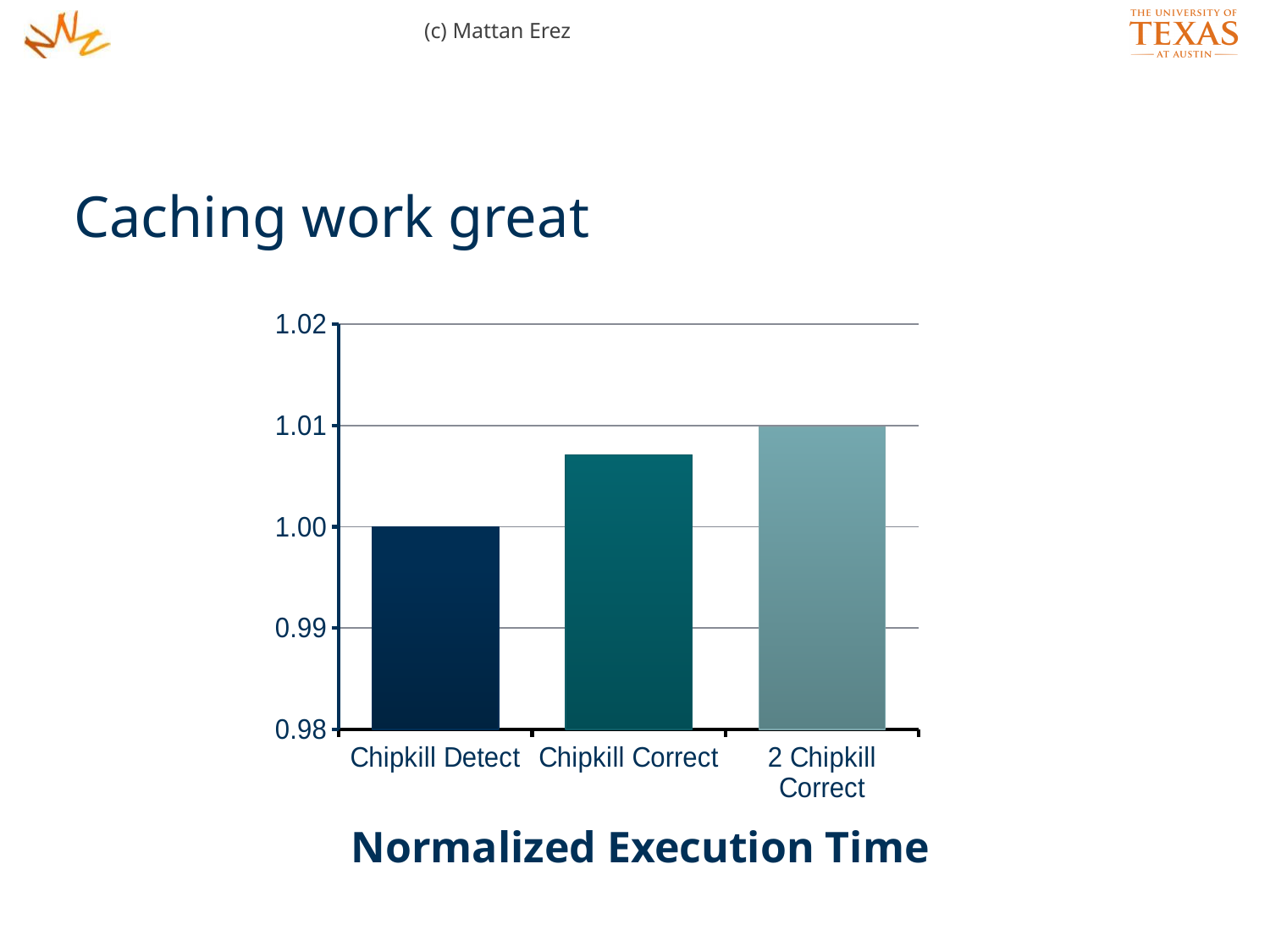
Do the values rise or fall from left to right across the categories? rise Which is larger, the value for Chipkill Correct or the value for Chipkill Detect? Chipkill Correct Is the value for Chipkill Correct greater or less than 1.00? greater What is the difference between the values for 2 Chipkill Correct and Chipkill Detect? 0.01 Which category has the highest normalized execution time? 2 Chipkill Correct What is the value for Chipkill Detect? 1.00 How many categories are shown in the chart? 3 Which category has the lowest normalized execution time? Chipkill Detect Is the value for Chipkill Correct greater or less than 1.01? less What is the title of the chart? Normalized Execution Time What kind of chart is shown on the slide? bar chart What is the value for 2 Chipkill Correct? 1.01